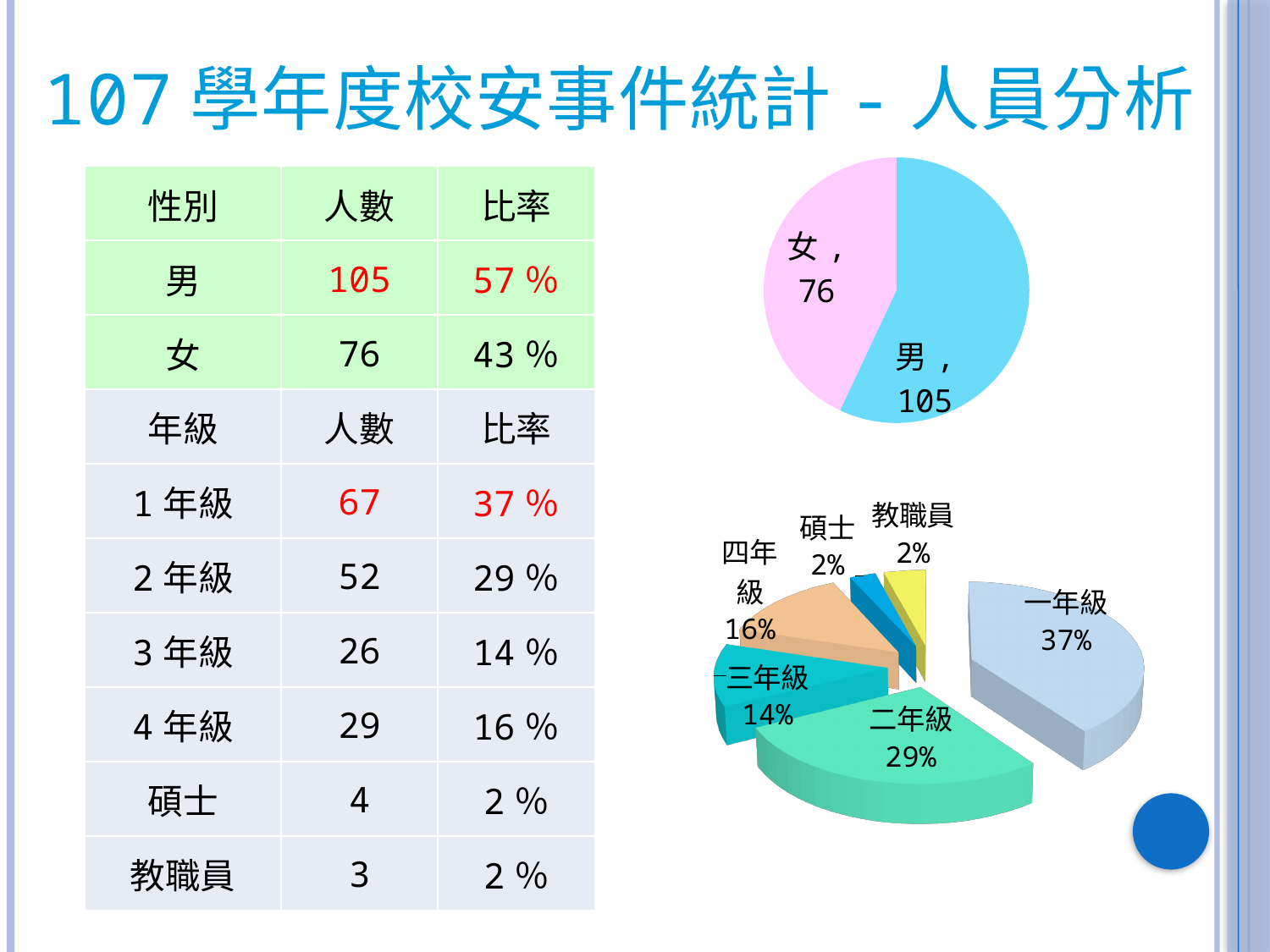
In the top pie chart, what is the value for 女? 76 In the top pie chart, what is the difference between the values for 男 and 女? 29 In the bottom pie chart, which category has the largest share? 一年級 How many slices does the top pie chart have? 2 In the top pie chart, which slice is larger, 男 or 女? 男 In the top pie chart, what is the value for 男? 105 In the bottom pie chart, what is the difference between the shares of 一年級 and 二年級? 8% What kind of chart is the top chart on the slide? pie chart In the bottom pie chart, which is larger, 四年級 or 三年級? 四年級 In the bottom pie chart, what share is labelled for 三年級? 14% How many slices does the bottom pie chart have? 6 In the bottom pie chart, what share is labelled for 一年級? 37%